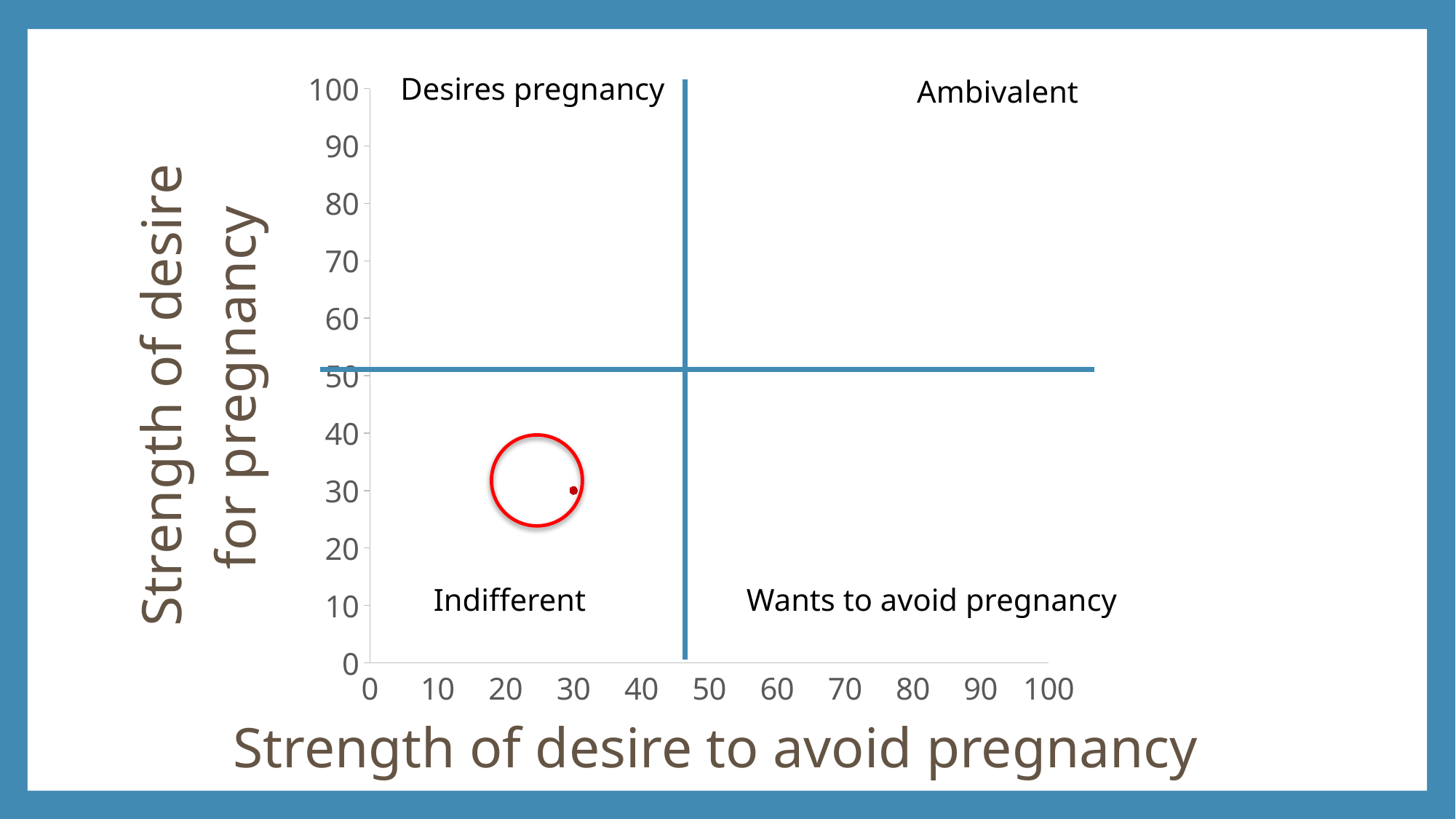
What is the title of the x axis? Strength of desire to avoid pregnancy How many data points are plotted on the chart? 1 Is the plotted point's strength of desire for pregnancy greater or less than 50? less What is the value on the x axis (strength of desire to avoid pregnancy) for the plotted point? 30 Is the plotted point's strength of desire for pregnancy greater or less than 20? greater What kind of chart is shown on the slide? scatter chart What is the value on the y axis (strength of desire for pregnancy) for the plotted point? 30 Which quadrant label does the plotted point fall in? Indifferent Is the plotted point's strength of desire to avoid pregnancy greater or less than 50? less